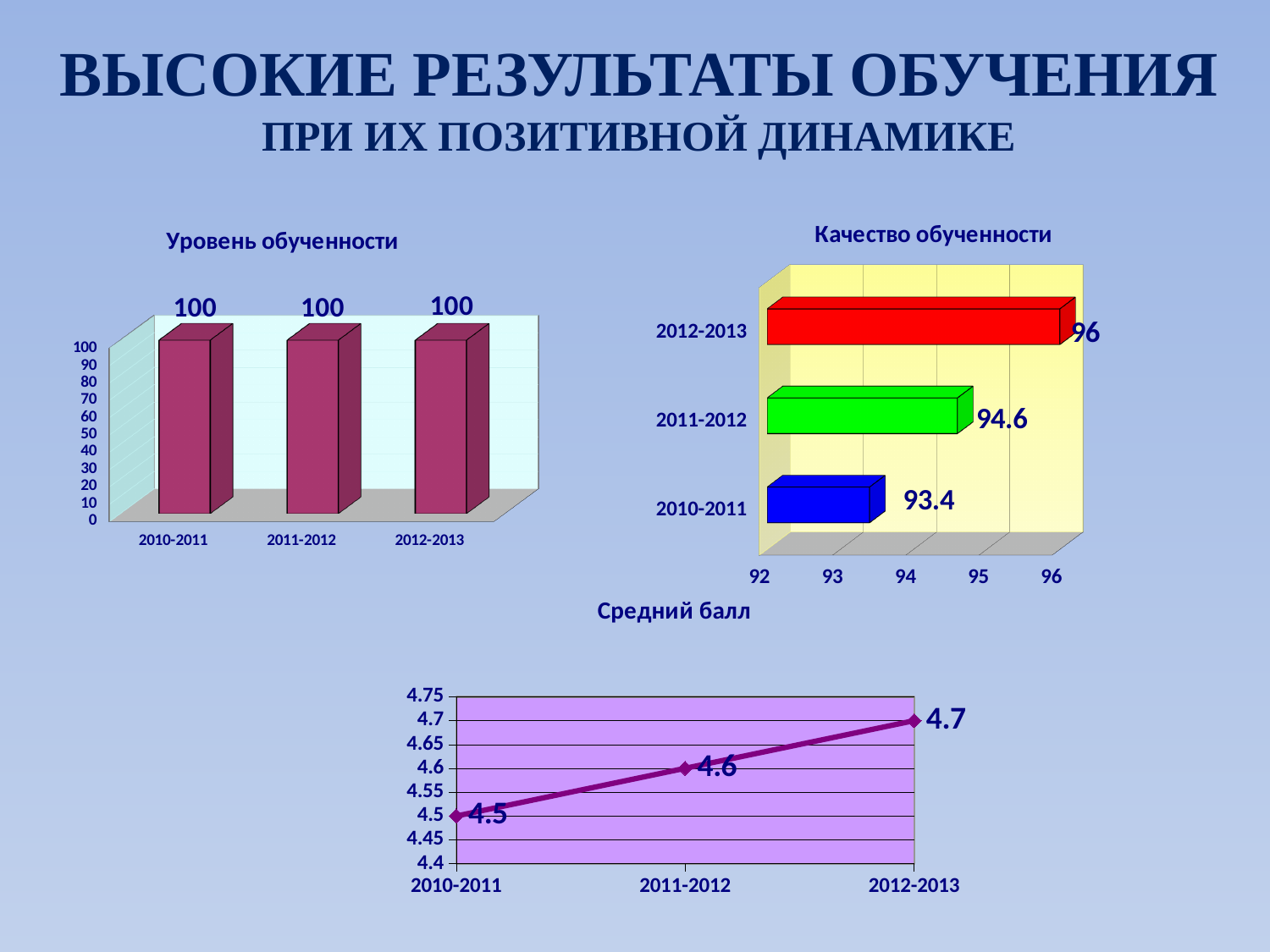
In the 'Качество обученности' chart, what is the value for 2010-2011? 93.4 What kind of chart is 'Средний балл'? line chart In the 'Уровень обученности' chart, how many categories are shown on the x axis? 3 In the 'Качество обученности' chart, which year has the highest value? 2012-2013 In the 'Качество обученности' chart, what is the difference between the values for 2012-2013 and 2010-2011? 2.6 In the 'Уровень обученности' chart, what is the value for 2011-2012? 100 In the 'Качество обученности' chart, what is the value for 2012-2013? 96 In the 'Качество обученности' chart, which year has the lowest value? 2010-2011 In the 'Средний балл' chart, what is the value for 2011-2012? 4.6 In the 'Средний балл' chart, do the values rise or fall from 2010-2011 to 2012-2013? rise What kind of chart is 'Уровень обученности'? bar chart In the 'Средний балл' chart, what is the difference between the values for 2012-2013 and 2010-2011? 0.2